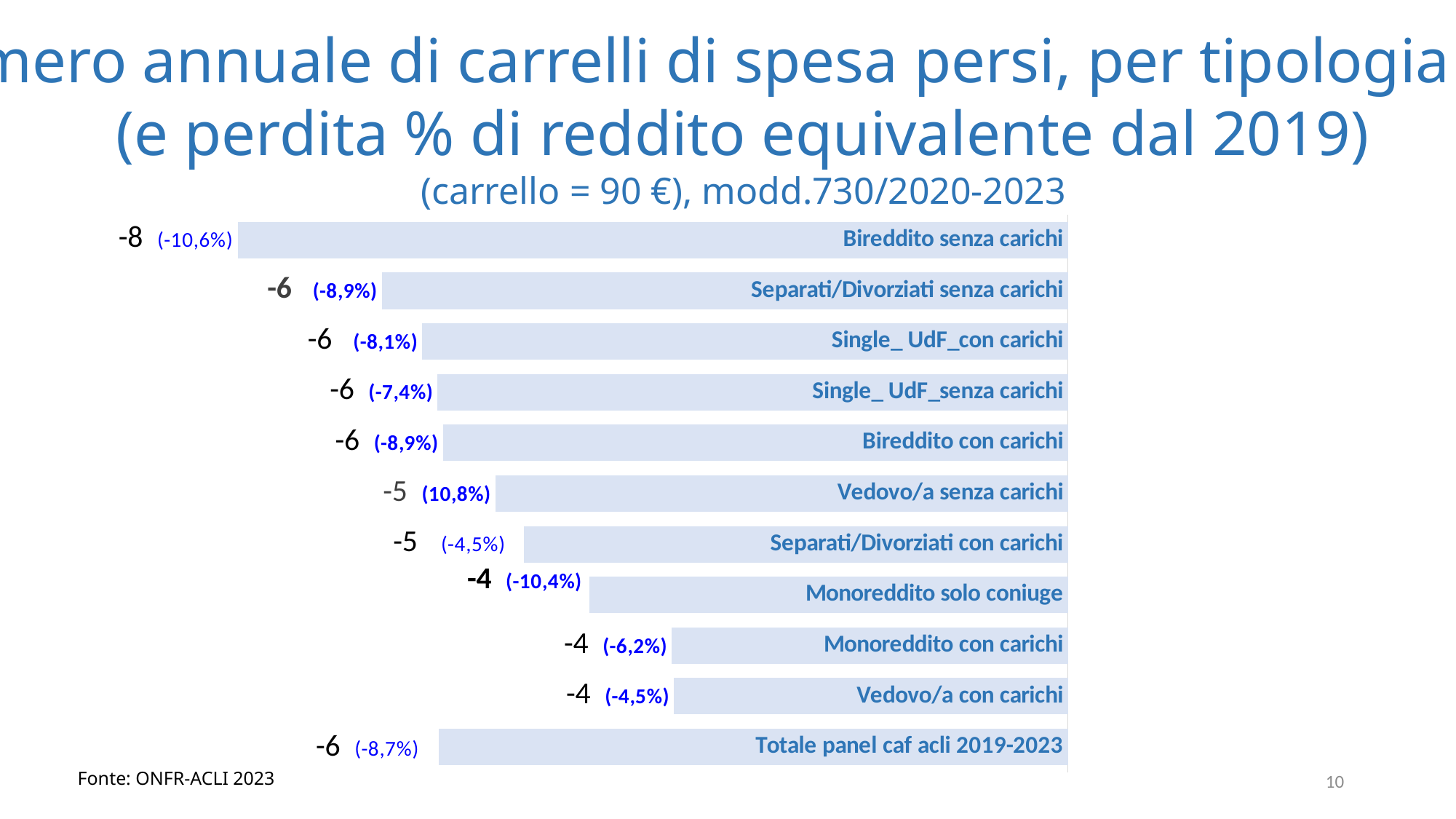
What percentage loss of equivalent income is shown in parentheses for Monoreddito con carichi? -6,2% Which category has the largest number of lost shopping carts (the longest bar)? Bireddito senza carichi What kind of chart is shown on the slide? Bar chart What is the source cited at the bottom of the slide? Fonte: ONFR-ACLI 2023 What is the value shown for Vedovo/a senza carichi? -5 What percentage loss of equivalent income is shown in parentheses for Bireddito senza carichi? -10,6% What is the value shown for Monoreddito solo coniuge? -4 What is the value shown for Totale panel caf acli 2019-2023? -6 Which shows a larger number of lost carts: Bireddito senza carichi or Monoreddito solo coniuge? Bireddito senza carichi What is the value shown for Bireddito senza carichi? -8 How many categories (bars) are shown in the chart? 11 What is the difference between the number of lost carts for Bireddito senza carichi and for Vedovo/a con carichi? 4